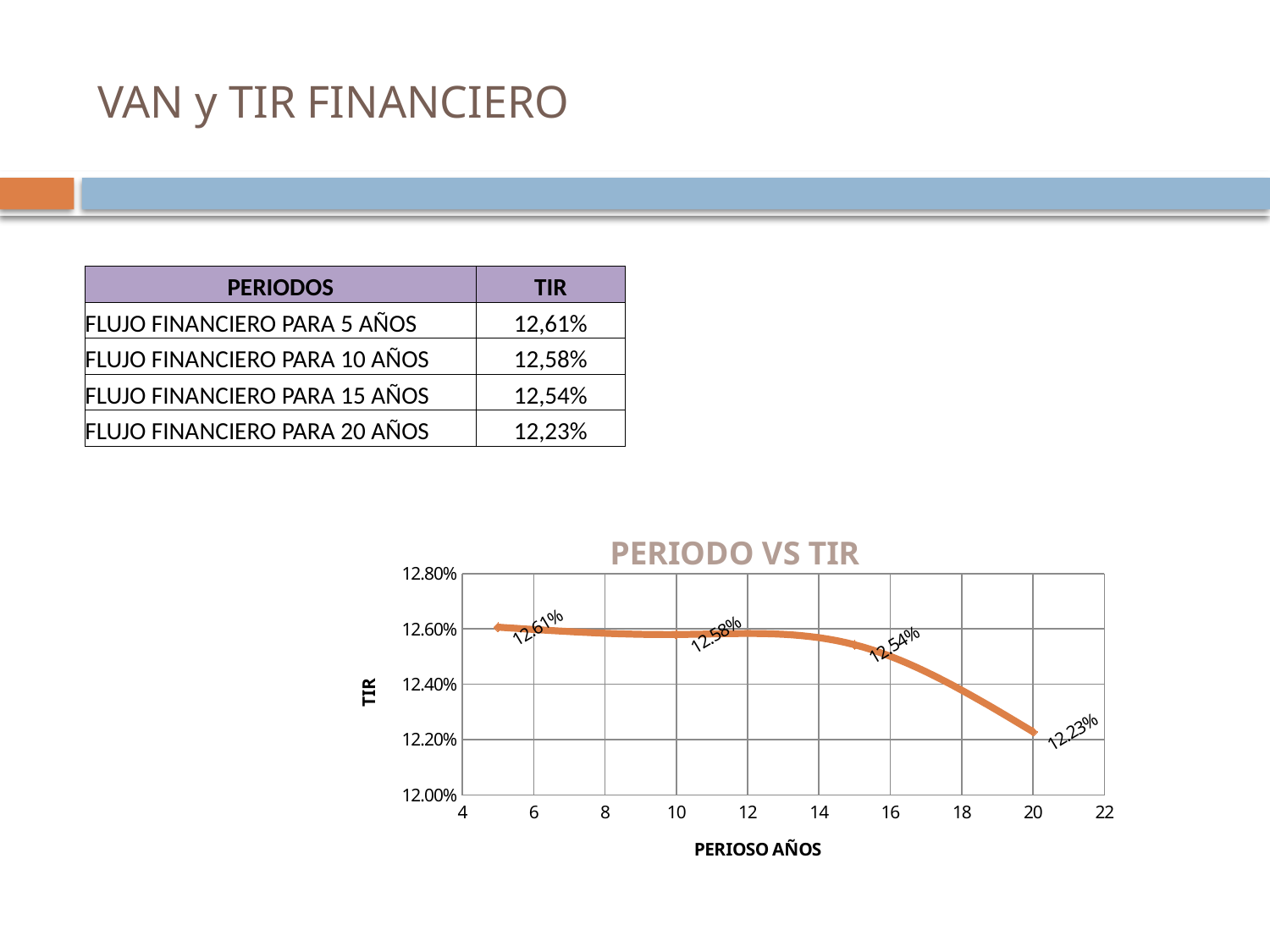
How many data points are plotted on the chart? 4 Is the TIR value at 20 years greater or less than 12.40%? less At which period (in years) is the TIR highest? 5 Which is larger, the TIR at 15 years or the TIR at 20 years? 15 years What is the TIR value plotted at period 10 years? 12.58% Does the TIR rise or fall as the period in years increases? fall What is the TIR value plotted at period 15 years? 12.54% What is the difference between the TIR at 5 years and the TIR at 20 years? 0.38% What is the TIR value plotted at period 20 years? 12.23% What is the TIR value plotted at period 5 years? 12.61% At which period (in years) is the TIR lowest? 20 What is the title of the chart? PERIODO VS TIR